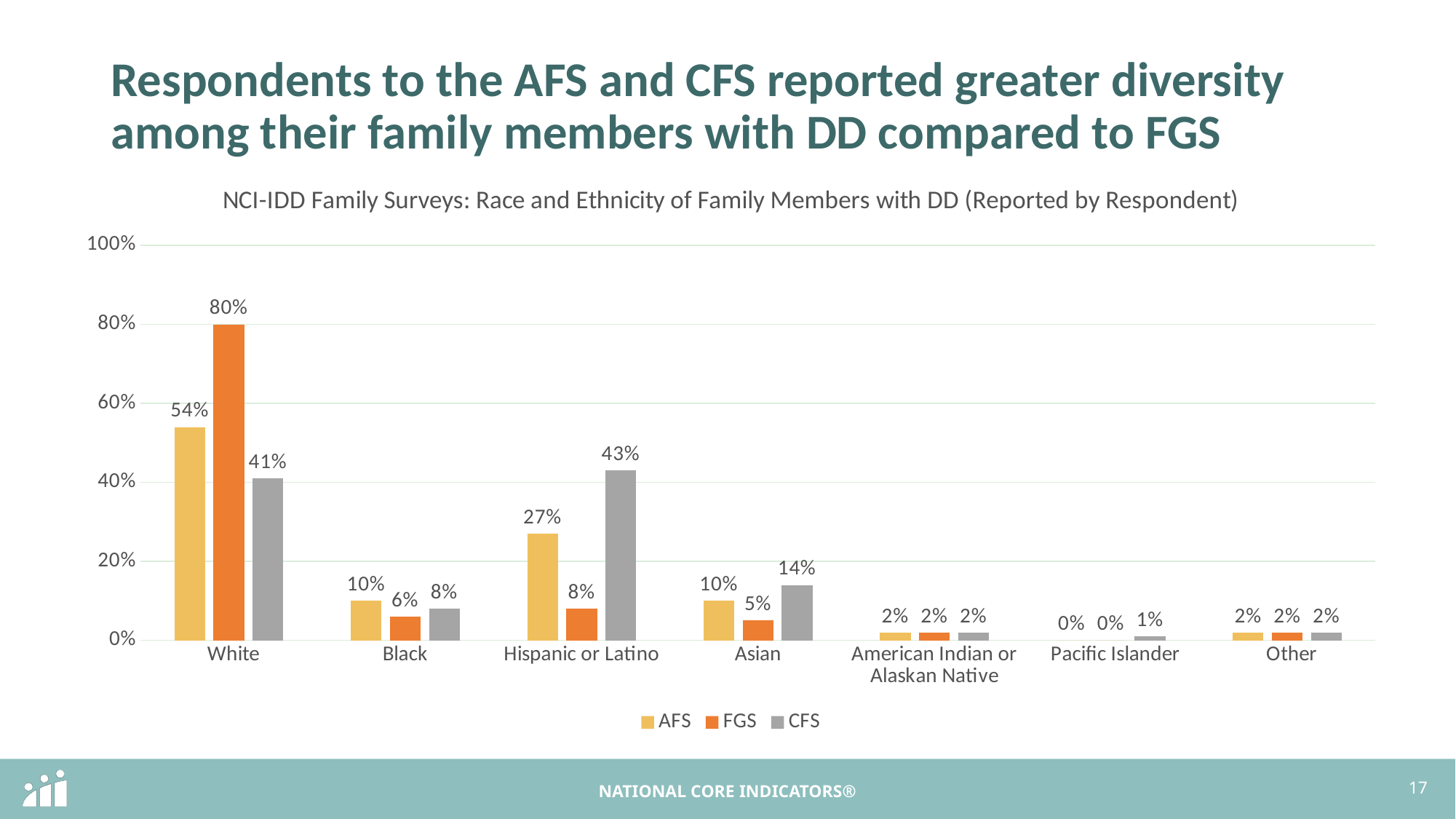
What is the CFS value for Hispanic or Latino? 43% What is the FGS value for White? 80% How many categories are shown on the x axis? 7 What kind of chart is shown on the slide? Bar chart Which is larger for Black: the AFS value or the CFS value? AFS Which category has the lowest AFS value? Pacific Islander What is the difference between the CFS and FGS values for Hispanic or Latino? 35% What is the difference between the FGS and AFS values for White? 26% How many series does the legend list? 3 Which category has the highest FGS value? White What is the AFS value for Asian? 10% What is the CFS value for Pacific Islander? 1%